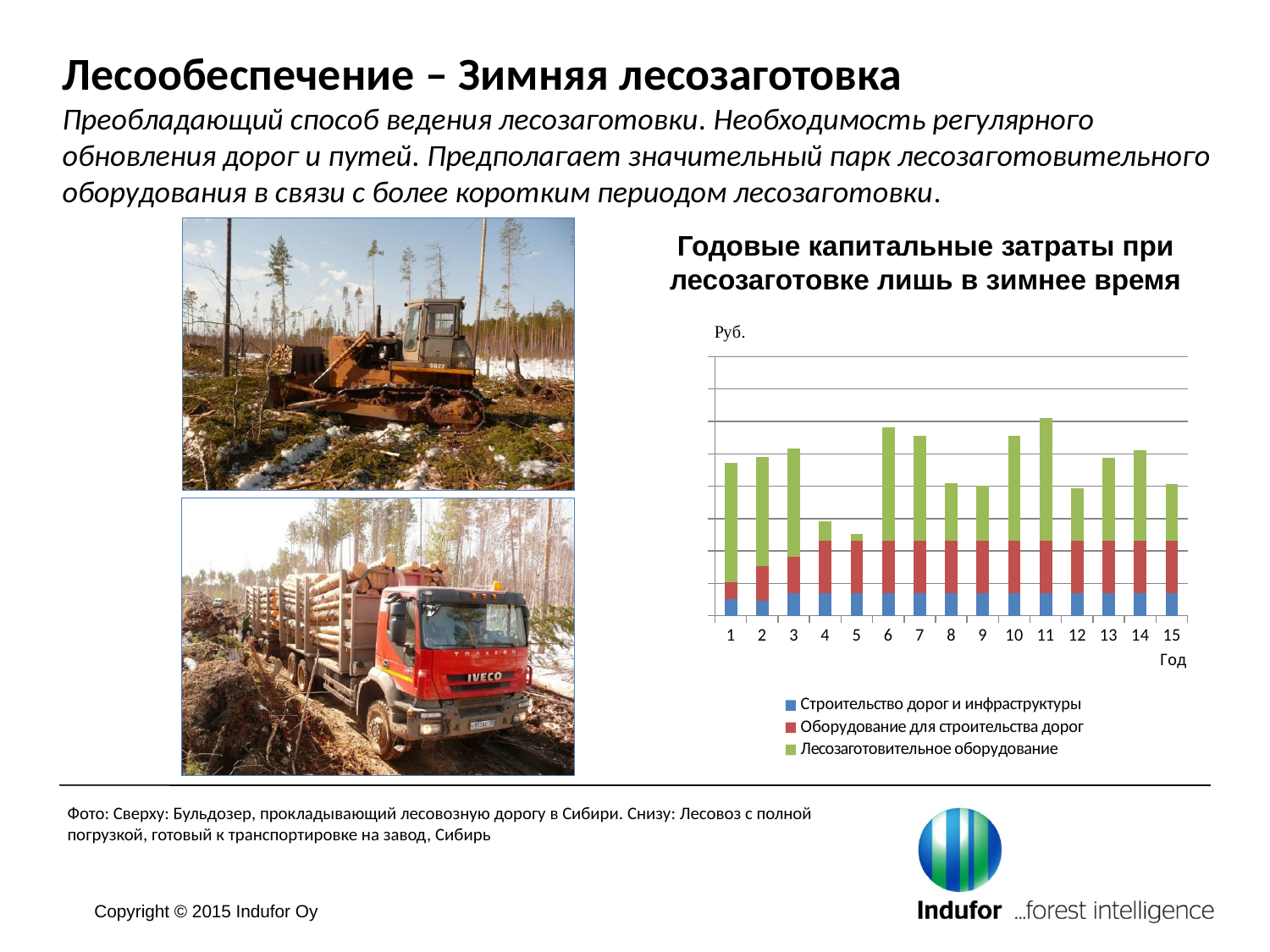
Which year has the larger total bar, year 1 or year 3? 3 Which series is shown in green in the chart? Лесозаготовительное оборудование Which year has the larger total bar, year 12 or year 13? 13 Which year has the lowest total annual capital cost? 5 Which year has the larger total bar, year 4 or year 6? 6 What is the title of the chart? Годовые капитальные затраты при лесозаготовке лишь в зимнее время Which year has the highest total annual capital cost? 11 What kind of chart is shown on the slide? Stacked bar chart How many years (categories) are plotted on the x axis? 15 How many series does the chart legend list? 3 Which series is shown in blue at the bottom of each stacked bar? Строительство дорог и инфраструктуры